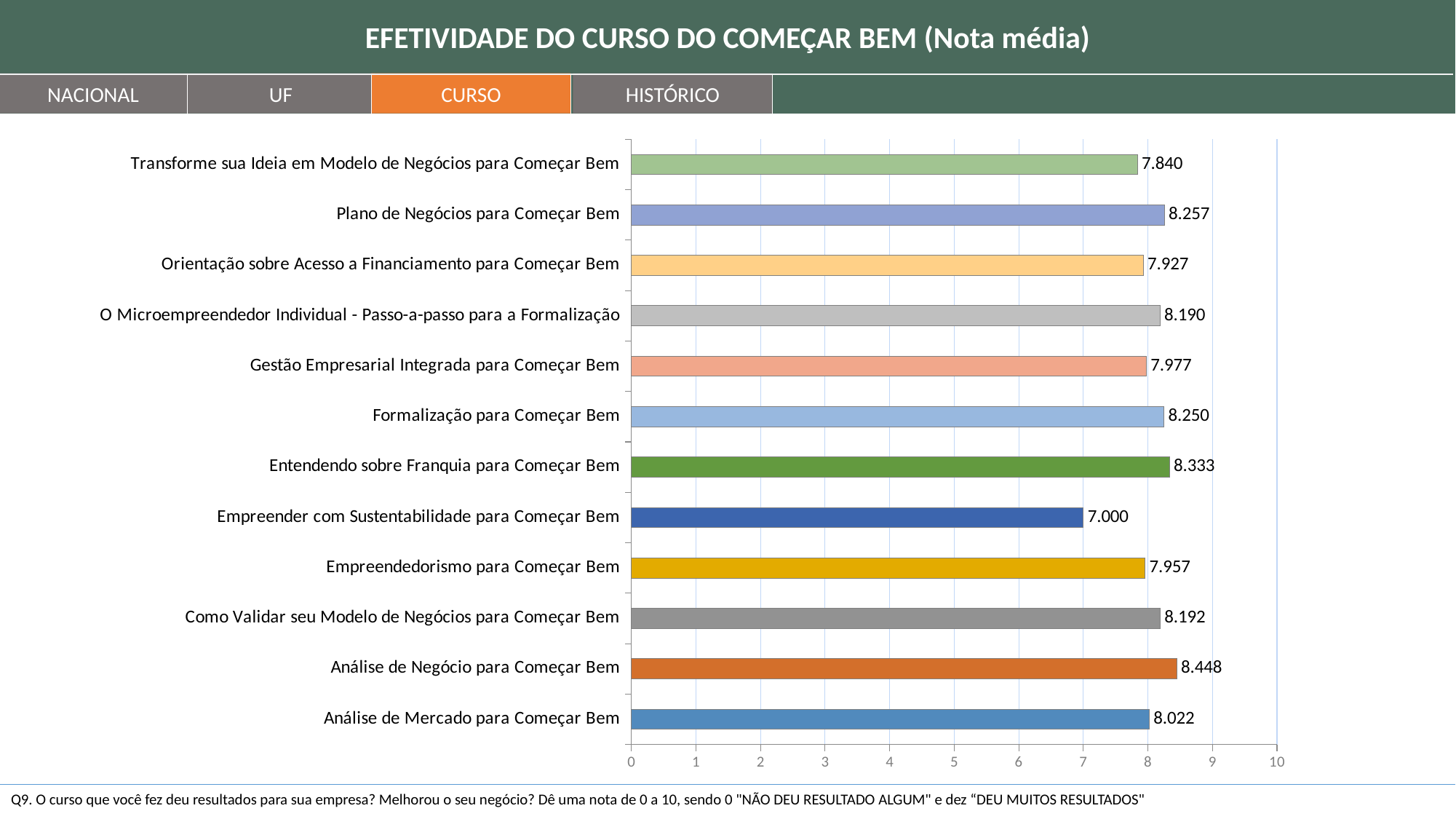
What is the title of the chart? EFETIVIDADE DO CURSO DO COMEÇAR BEM (Nota média) What kind of chart is shown on the slide? Bar chart Which course has the lowest average score? Empreender com Sustentabilidade para Começar Bem Which has a higher score: Entendendo sobre Franquia para Começar Bem or Formalização para Começar Bem? Entendendo sobre Franquia para Começar Bem How many courses are shown in the chart? 12 What is the average score for Plano de Negócios para Começar Bem? 8.257 What is the average score for Empreender com Sustentabilidade para Começar Bem? 7.000 What is the difference between the scores for Análise de Negócio para Começar Bem and Empreender com Sustentabilidade para Começar Bem? 1.448 Which course has the highest average score? Análise de Negócio para Começar Bem What is the difference between the scores for Como Validar seu Modelo de Negócios para Começar Bem and O Microempreendedor Individual - Passo-a-passo para a Formalização? 0.002 Is the value for Transforme sua Ideia em Modelo de Negócios para Começar Bem greater or less than 8? less What is the average score for Análise de Negócio para Começar Bem? 8.448